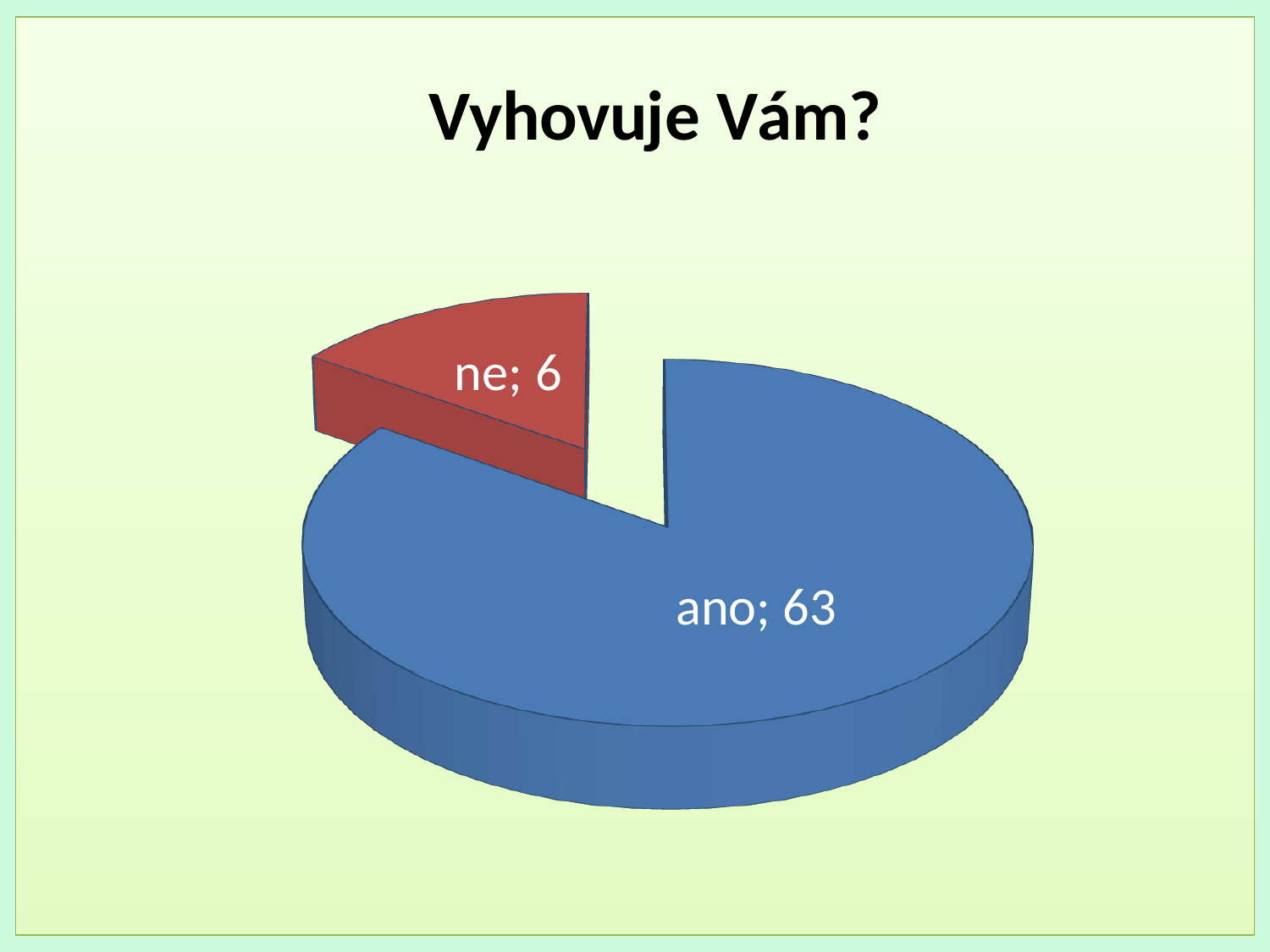
What colour is the "ne" slice? red What kind of chart is shown on the slide? pie chart What is the title of the chart? Vyhovuje Vám? Which slice is the smallest? ne Which slice is the largest? ano What is the value for "ano"? 63 What is the total of all slices in the pie chart? 69 What is the difference between the values for "ano" and "ne"? 57 Which is larger, "ano" or "ne"? ano What is the value for "ne"? 6 How many slices does the pie chart have? 2